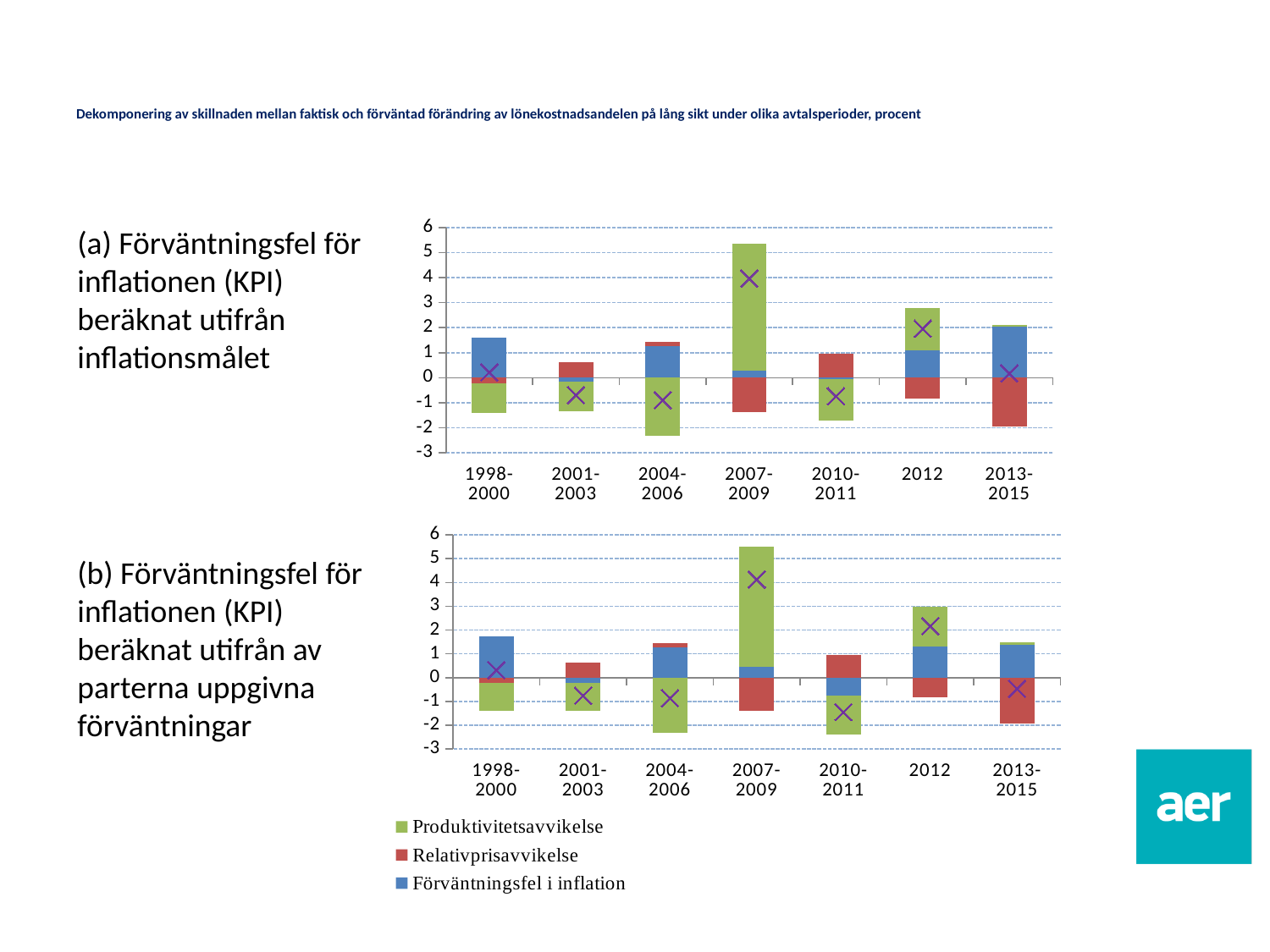
How many avtalsperioder (categories) are shown on the x axis of chart (b)? 7 In chart (a), is the X marker for 2012 greater or less than 1? greater In chart (a), which is higher, the X marker for 2007-2009 or the X marker for 2012? 2007-2009 In chart (b), which green Produktivitetsavvikelse bar is taller, 2012 or 2013-2015? 2012 In chart (b), which period has the lowest X marker? 2010-2011 In chart (b), is the green Produktivitetsavvikelse bar for 2007-2009 greater or less than 4? greater What kind of chart is chart (a), 'Förväntningsfel för inflationen (KPI) beräknat utifrån inflationsmålet'? Stacked bar chart In chart (a), is the red Relativprisavvikelse bar for 2013-2015 greater or less than -1? less How many series does the legend below the charts list? 3 Which series is shown in green in the legend? Produktivitetsavvikelse What is the third entry in the legend below the charts? Förväntningsfel i inflation In chart (a), which period has the tallest green Produktivitetsavvikelse bar? 2007-2009